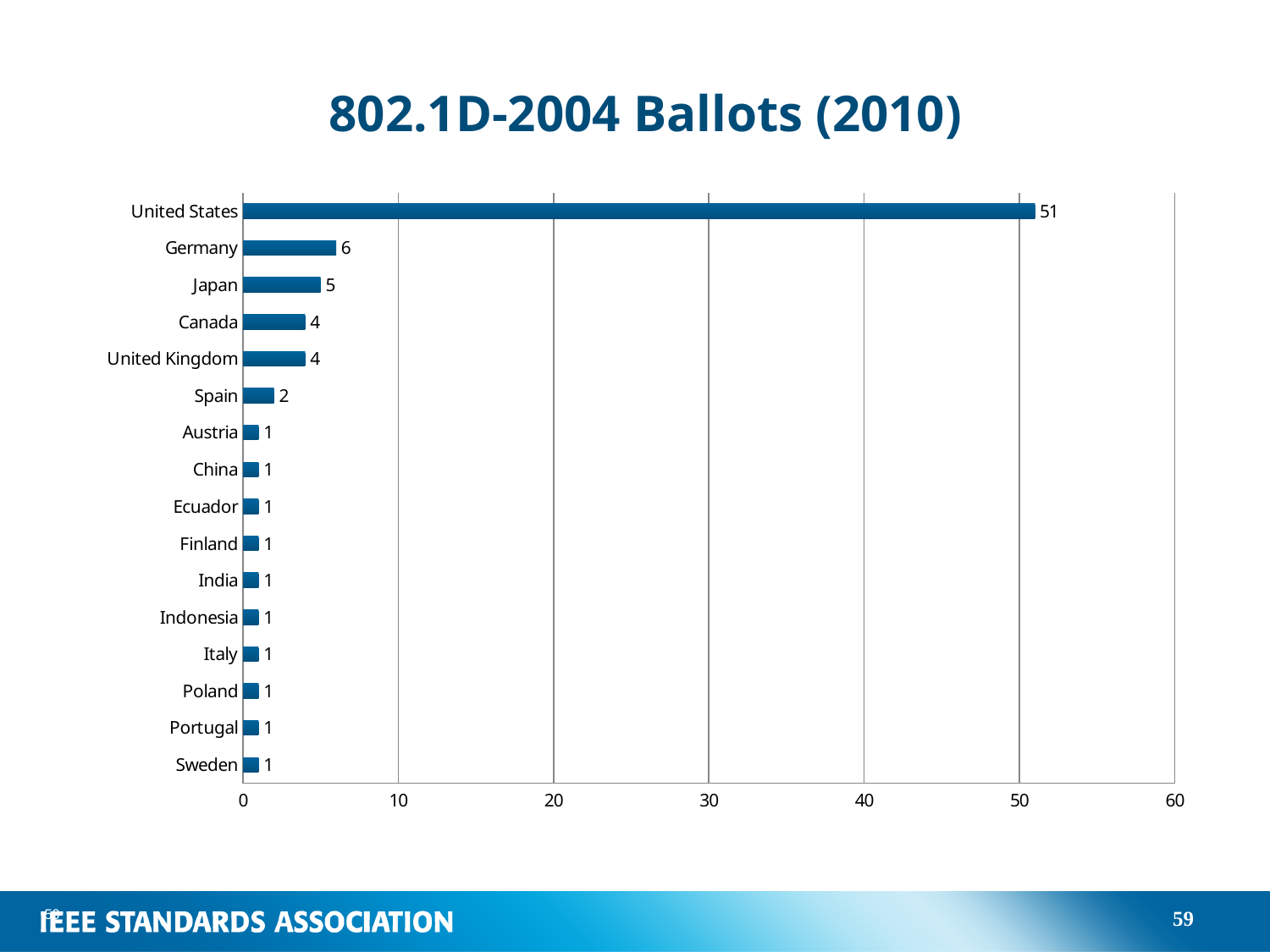
Which is larger, the value for Germany or the value for Japan? Germany What is the difference between the values for Japan and Canada? 1 What is the value for United States? 51 What is the difference between the values for United States and Germany? 45 What is the value for Spain? 2 What is the value for Japan? 5 Is the value for United States greater or less than 50? greater What is the title of the chart? 802.1D-2004 Ballots (2010) Which country has the highest value? United States What kind of chart is shown on the slide? bar chart What is the value for Germany? 6 How many countries are shown on the chart? 16